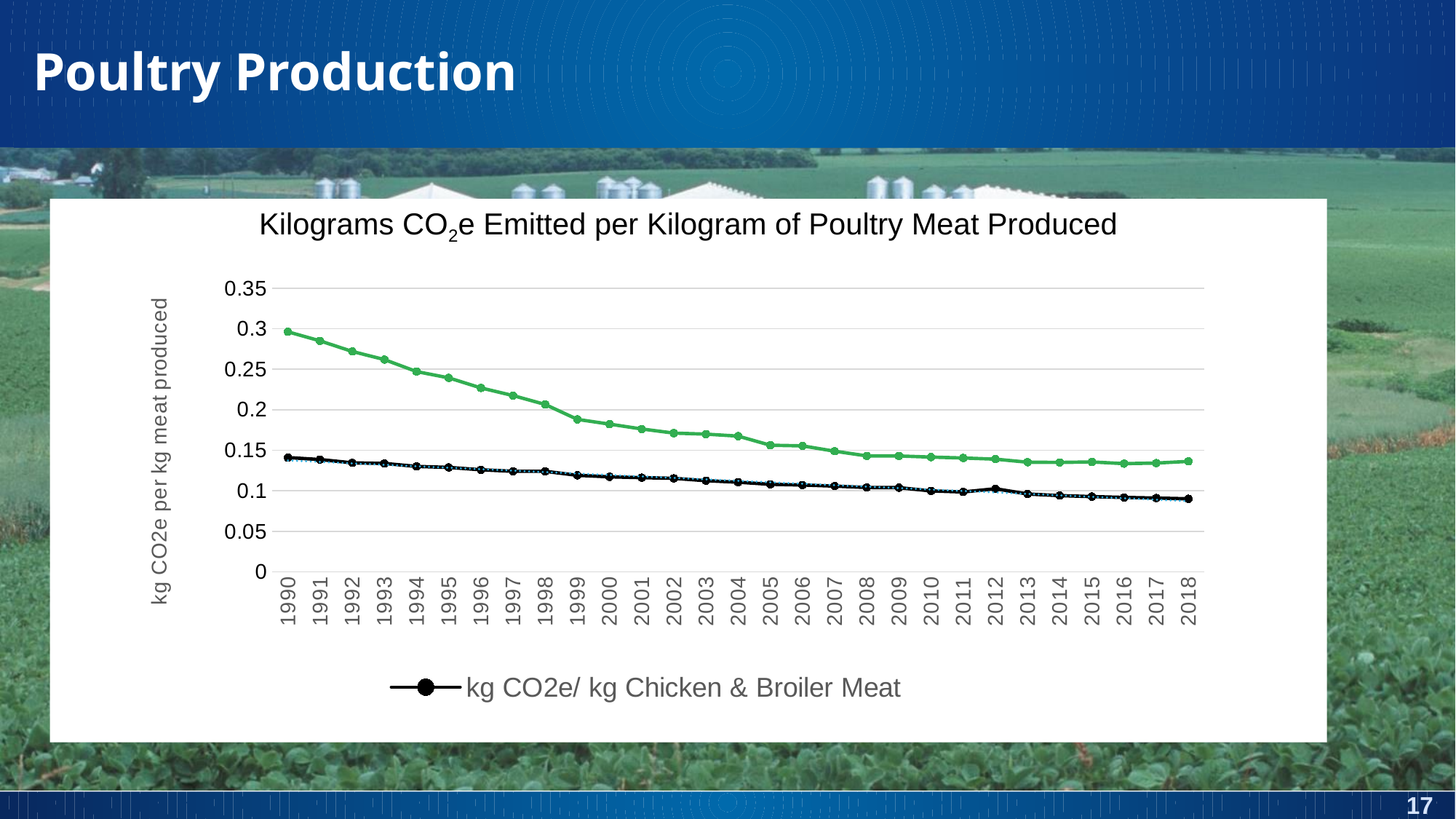
What is the title of the chart? Kilograms CO2e Emitted per Kilogram of Poultry Meat Produced Which is larger for the green line: the value in 1990 or the value in 2018? 1990 Do the values of the green line rise or fall from 1990 to 2018? fall In which year is the green line at its highest value? 1990 How many series does the legend list? 1 What kind of chart is shown on the slide? line chart What series name does the legend list? kg CO2e/ kg Chicken & Broiler Meat Is the value of the green line in 2018 greater or less than 0.15? less Is the value for kg CO2e/ kg Chicken & Broiler Meat in 2018 greater or less than 0.1? less How many years are plotted along the x axis? 29 Is the value of the green line in 1990 greater or less than 0.25? greater